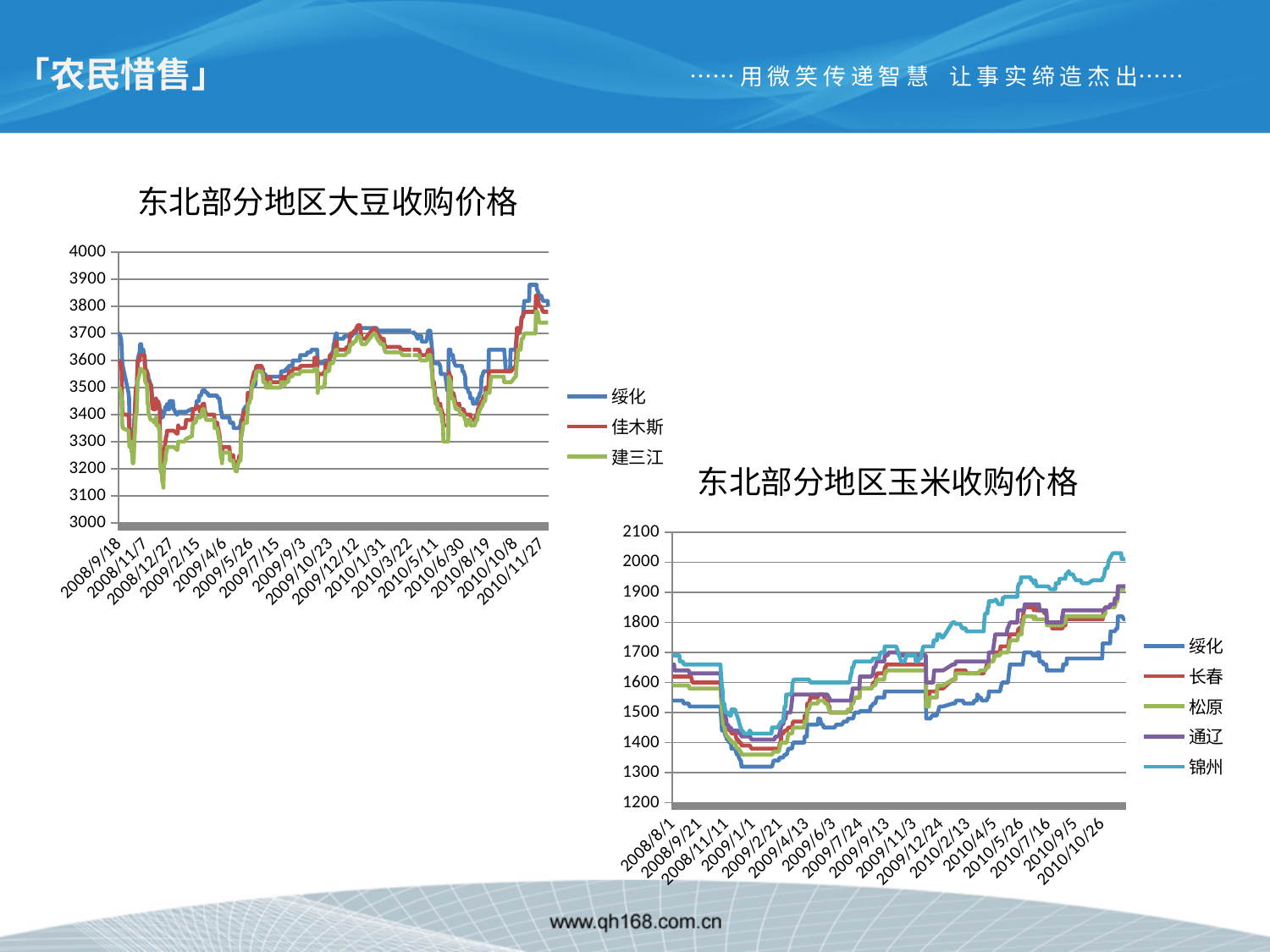
How many series does the legend of the 东北部分地区大豆收购价格 chart list? 3 In the 东北部分地区玉米收购价格 chart, is the lowest value of 绥化 greater or less than 1400? less What kind of chart is the 东北部分地区大豆收购价格 chart? line chart What are the legend entries of the 东北部分地区玉米收购价格 chart? 绥化, 长春, 松原, 通辽, 锦州 What kind of chart is the 东北部分地区玉米收购价格 chart? line chart How many series does the legend of the 东北部分地区玉米收购价格 chart list? 5 In the 东北部分地区玉米收购价格 chart, which series has the highest value at the right end of the x axis? 锦州 In the 东北部分地区玉米收购价格 chart, which series has the lowest value at the right end of the x axis? 绥化 In the 东北部分地区大豆收购价格 chart, is the highest value of 绥化 greater or less than 3800? greater In the 东北部分地区玉米收购价格 chart, is the final value of 锦州 greater or less than 1900? greater In the 东北部分地区玉米收购价格 chart, do the values generally rise or fall from the left end to the right end of the x axis? rise